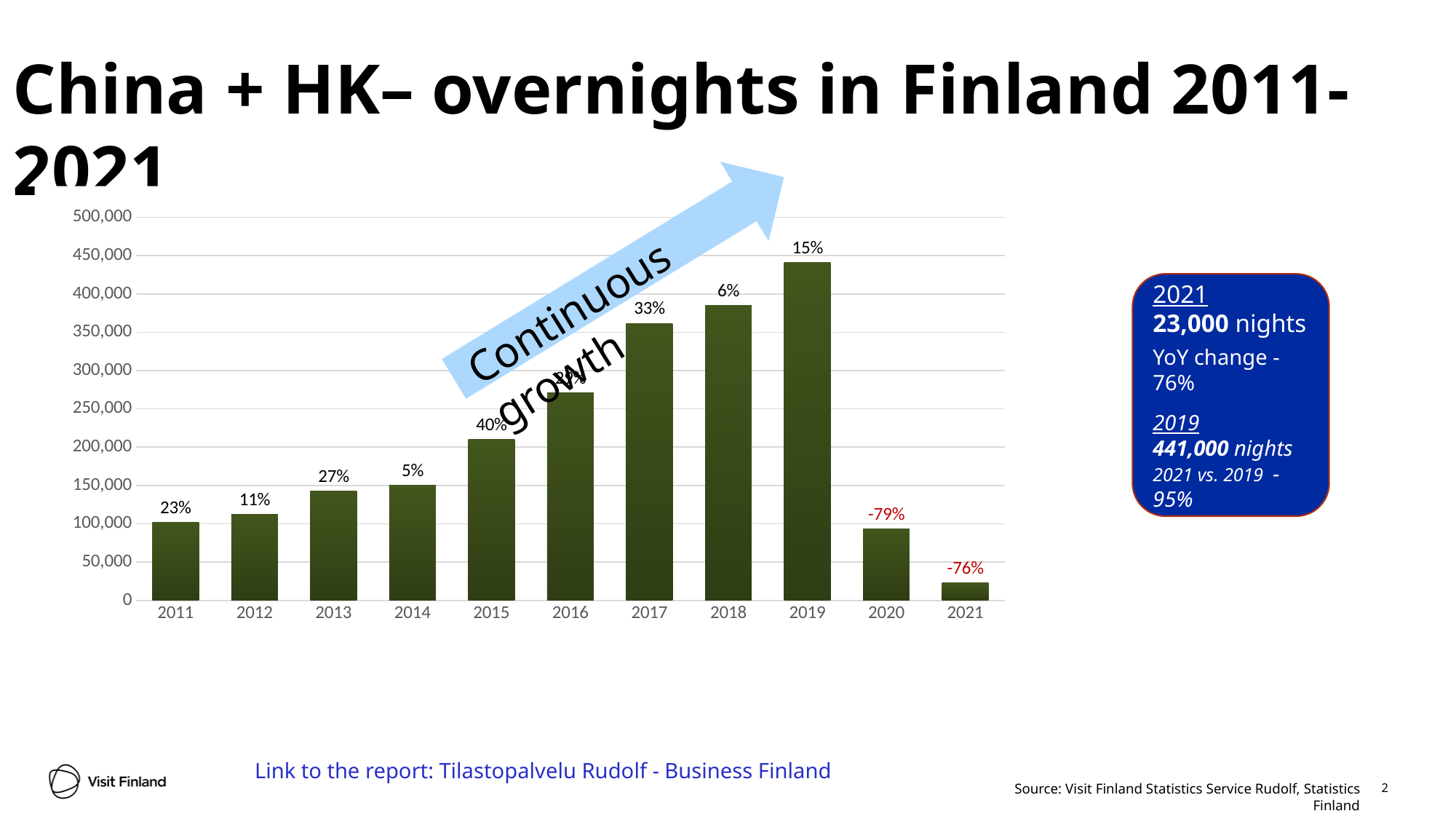
What percentage label is shown above the 2013 bar? 27% What percentage label is shown above the 2020 bar? -79% Which year has the larger bar, 2017 or 2018? 2018 What percentage label is shown above the 2015 bar? 40% Is the value for 2018 greater or less than 350,000? greater Which year has the lowest bar in the chart? 2021 How many years are shown on the x axis of the chart? 11 What kind of chart is shown on the slide? bar chart Do the bar values rise or fall from 2011 to 2019? rise Which year has the highest bar in the chart? 2019 Is the value for 2012 greater or less than 150,000? less What percentage label is shown above the 2021 bar? -76%